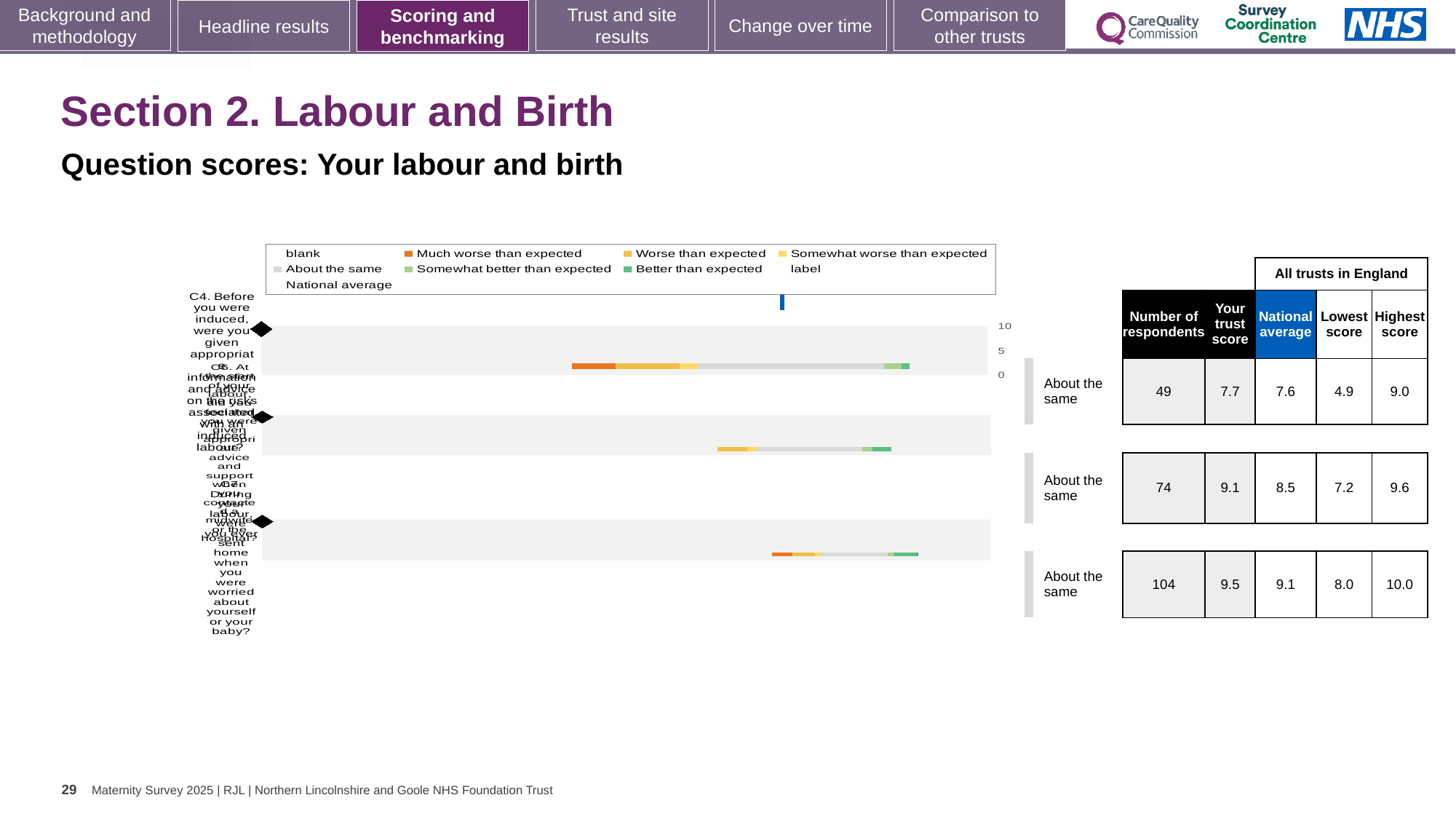
In the table, what is the national average for the third (bottom) question row? 9.1 What kind of chart is shown on the slide? bar chart In the table, what is the highest score for the first question row? 9.0 In the table, what is the lowest score for the second question row? 7.2 In the table, what is the number of respondents for the first (top) question row? 49 What benchmark category is shown next to each of the three question rows? About the same What colour represents 'Much worse than expected' in the chart legend? orange For the third question row, what is the difference between 'Your trust score' and the national average? 0.4 Which question row has the largest number of respondents? the third (bottom) row, with 104 In the table, what is 'Your trust score' for the second question row? 9.1 How many question rows (bars) are plotted in the chart? 3 For the first question row, which is larger: 'Your trust score' or the national average? Your trust score